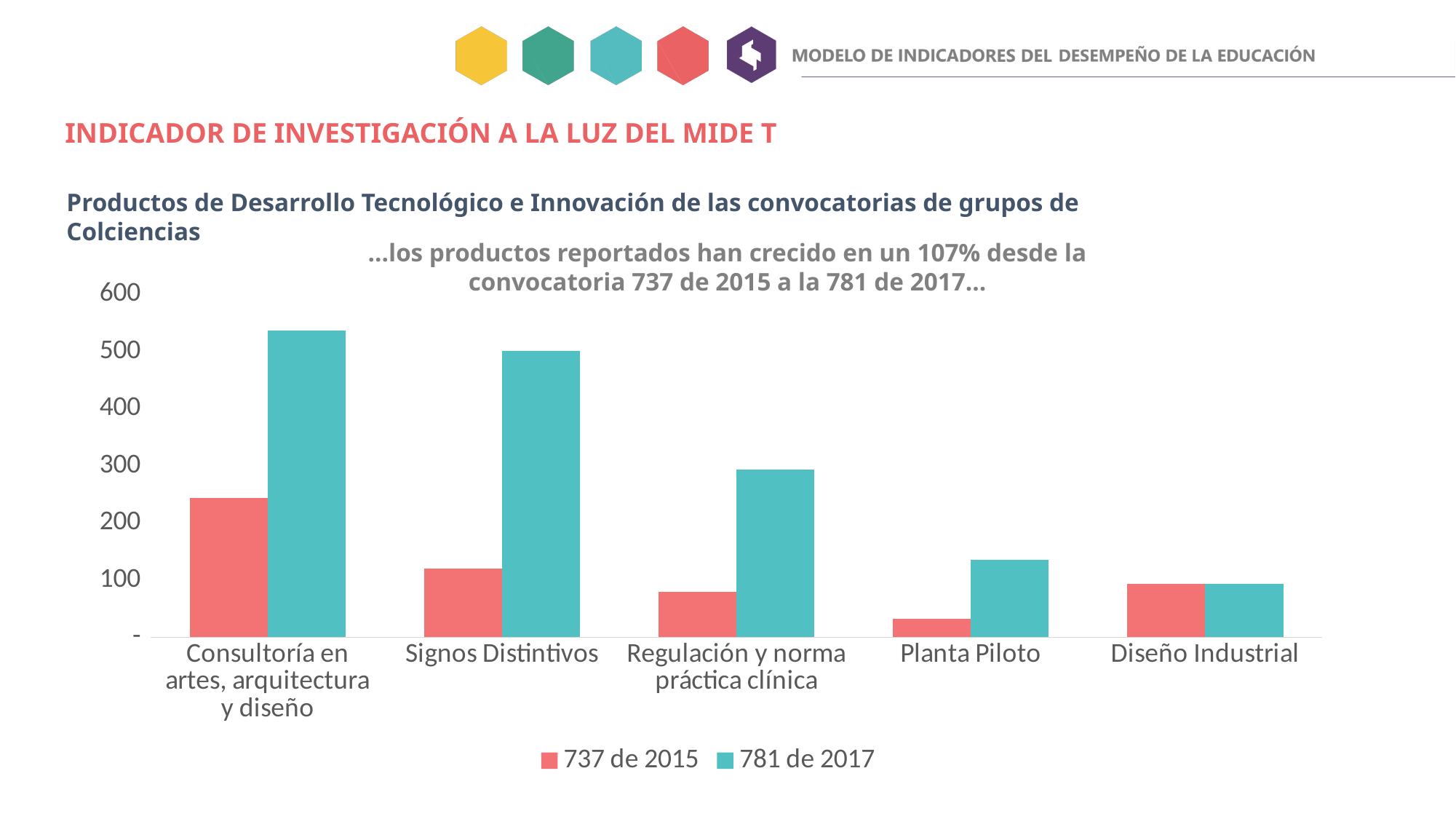
Which category has the highest value for the 781 de 2017 series? Consultoría en artes, arquitectura y diseño Is the value for Regulación y norma práctica clínica in the 781 de 2017 series greater or less than 200? greater What kind of chart is shown on the slide? bar chart What colour are the bars for the 781 de 2017 series? teal For Signos Distintivos, which series has the larger value: 737 de 2015 or 781 de 2017? 781 de 2017 How many series does the chart legend list? 2 Is the value for Consultoría en artes, arquitectura y diseño in the 781 de 2017 series greater or less than 500? greater Which category has the lowest value for the 737 de 2015 series? Planta Piloto How many categories are shown on the x axis of the chart? 5 Which category has the lowest value for the 781 de 2017 series? Diseño Industrial Is the value for Planta Piloto in the 737 de 2015 series greater or less than 100? less What are the two series named in the chart legend? 737 de 2015 and 781 de 2017